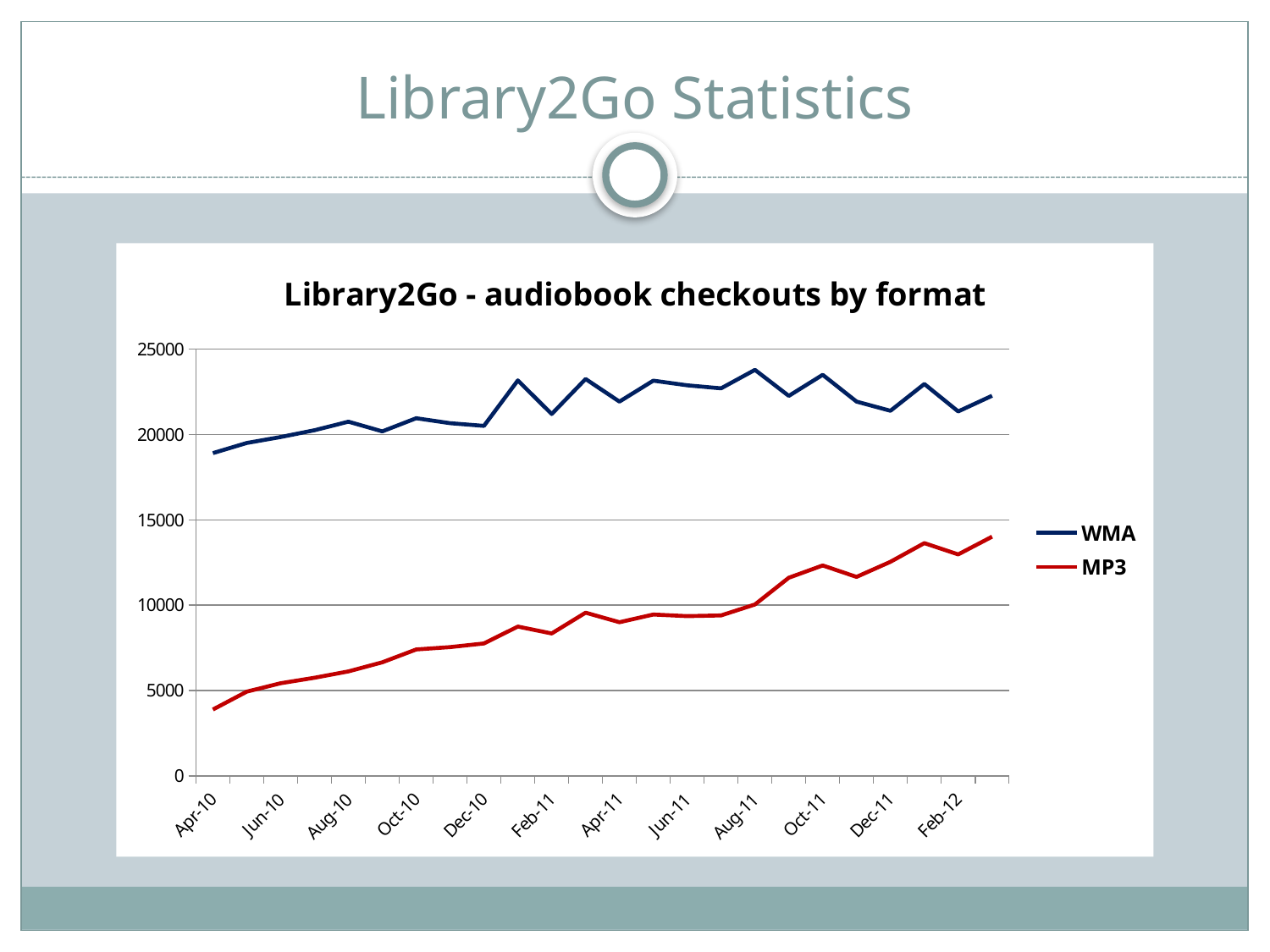
What is the title of the chart? Library2Go - audiobook checkouts by format Is the value for MP3 at Feb-12 greater or less than 10000? greater Which series is drawn in red? MP3 How many month labels are shown on the x axis? 12 Is the value for MP3 at Apr-10 greater or less than 5000? less Is the value for WMA at Aug-11 greater or less than 25000? less Do the MP3 values generally rise or fall from Apr-10 to Feb-12? rise What kind of chart is shown on the slide? line chart Which series has higher values throughout the chart, WMA or MP3? WMA How many series does the legend list? 2